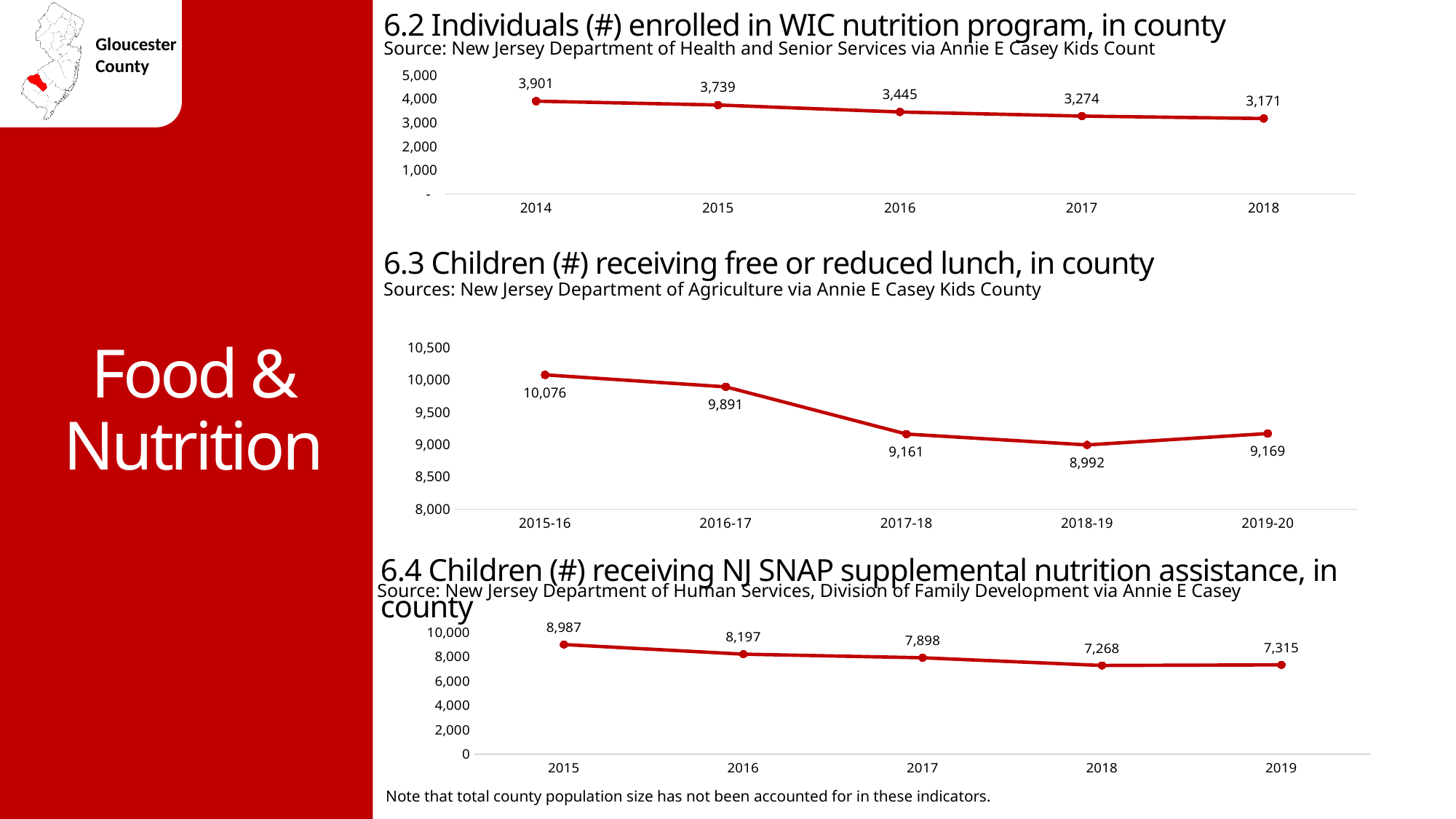
In the chart '6.4 Children (#) receiving NJ SNAP supplemental nutrition assistance, in county', what is the value for 2017? 7,898 In the chart '6.3 Children (#) receiving free or reduced lunch, in county', what is the value for 2018-19? 8,992 In the chart '6.2 Individuals (#) enrolled in WIC nutrition program, in county', what is the difference between the 2014 and 2018 values? 730 In the chart '6.3 Children (#) receiving free or reduced lunch, in county', what is the difference between the 2015-16 and 2016-17 values? 185 In the chart '6.3 Children (#) receiving free or reduced lunch, in county', which school year has the highest value? 2015-16 In the chart '6.4 Children (#) receiving NJ SNAP supplemental nutrition assistance, in county', which is larger, the value for 2018 or the value for 2019? 2019 In the chart '6.2 Individuals (#) enrolled in WIC nutrition program, in county', do the values rise or fall from 2014 to 2018? fall In the chart '6.3 Children (#) receiving free or reduced lunch, in county', how many data points are plotted? 5 In the chart '6.4 Children (#) receiving NJ SNAP supplemental nutrition assistance, in county', is the value for 2015 greater or less than 8,000? greater In the chart '6.2 Individuals (#) enrolled in WIC nutrition program, in county', what is the value for 2014? 3,901 In the chart '6.2 Individuals (#) enrolled in WIC nutrition program, in county', which year has the lowest value? 2018 What type of chart is '6.4 Children (#) receiving NJ SNAP supplemental nutrition assistance, in county'? line chart